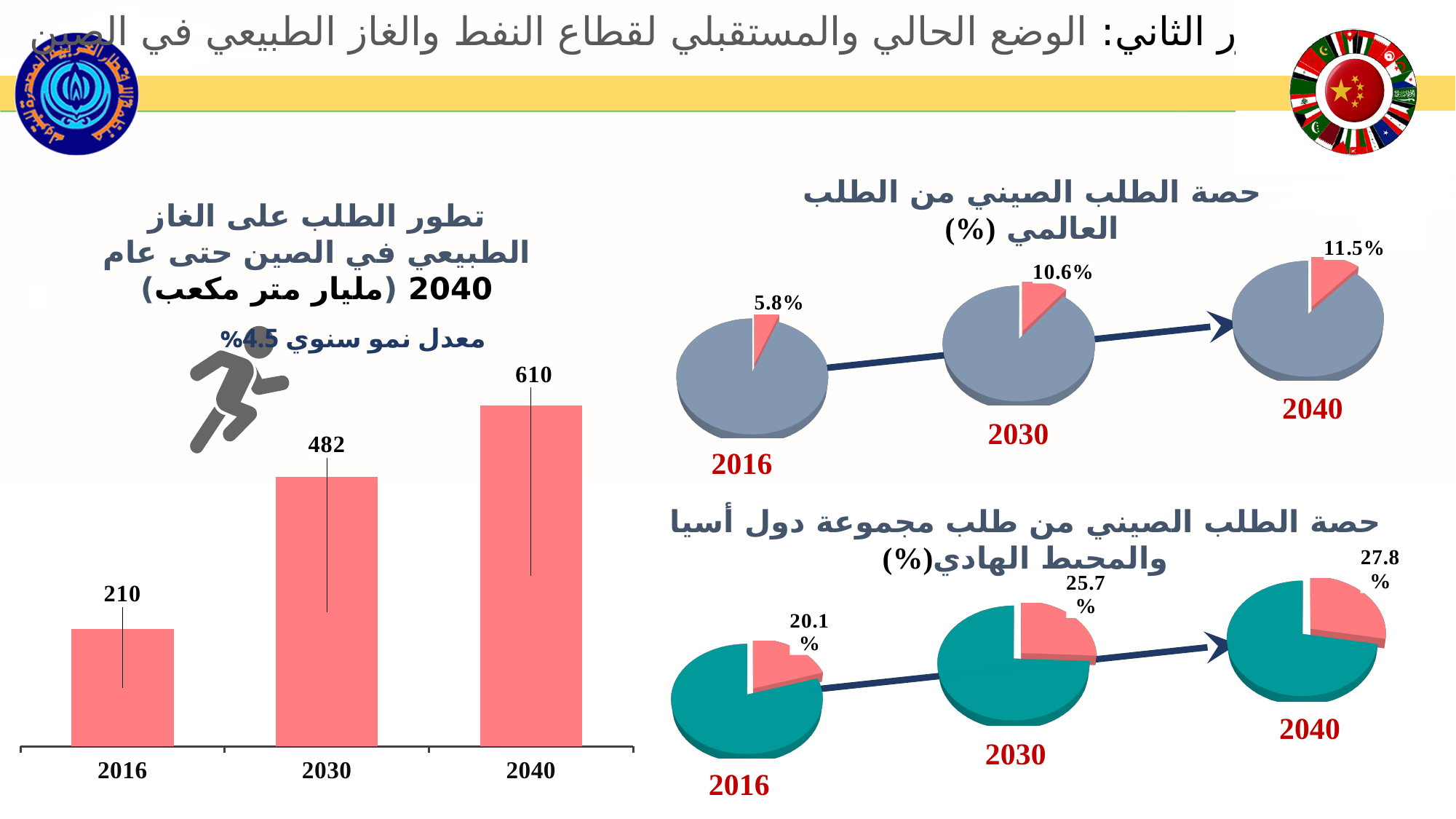
In the bar chart on the left, what is the value for 2030? 482 In the top-right pie charts (China's share of global demand), what is the share shown for 2016? 5.8% What annual growth rate is stated above the bar chart on the left? 4.5% In the bar chart on the left, which year has the lowest value? 2016 In the bar chart on the left, do the values rise or fall from 2016 to 2040? rise In the bottom-right pie charts (China's share of Asia-Pacific group demand), which year has the highest share? 2040 In the bar chart on the left, what is the difference between the 2040 and 2016 values? 400 In the bar chart on the left, what is the value for 2040? 610 In the bottom-right pie charts (China's share of Asia-Pacific group demand), what is the share shown for 2030? 25.7% In the top-right pie charts (China's share of global demand), what is the share shown for 2040? 11.5% How many bars are in the bar chart on the left? 3 What kind of chart is the chart on the left of the slide? bar chart